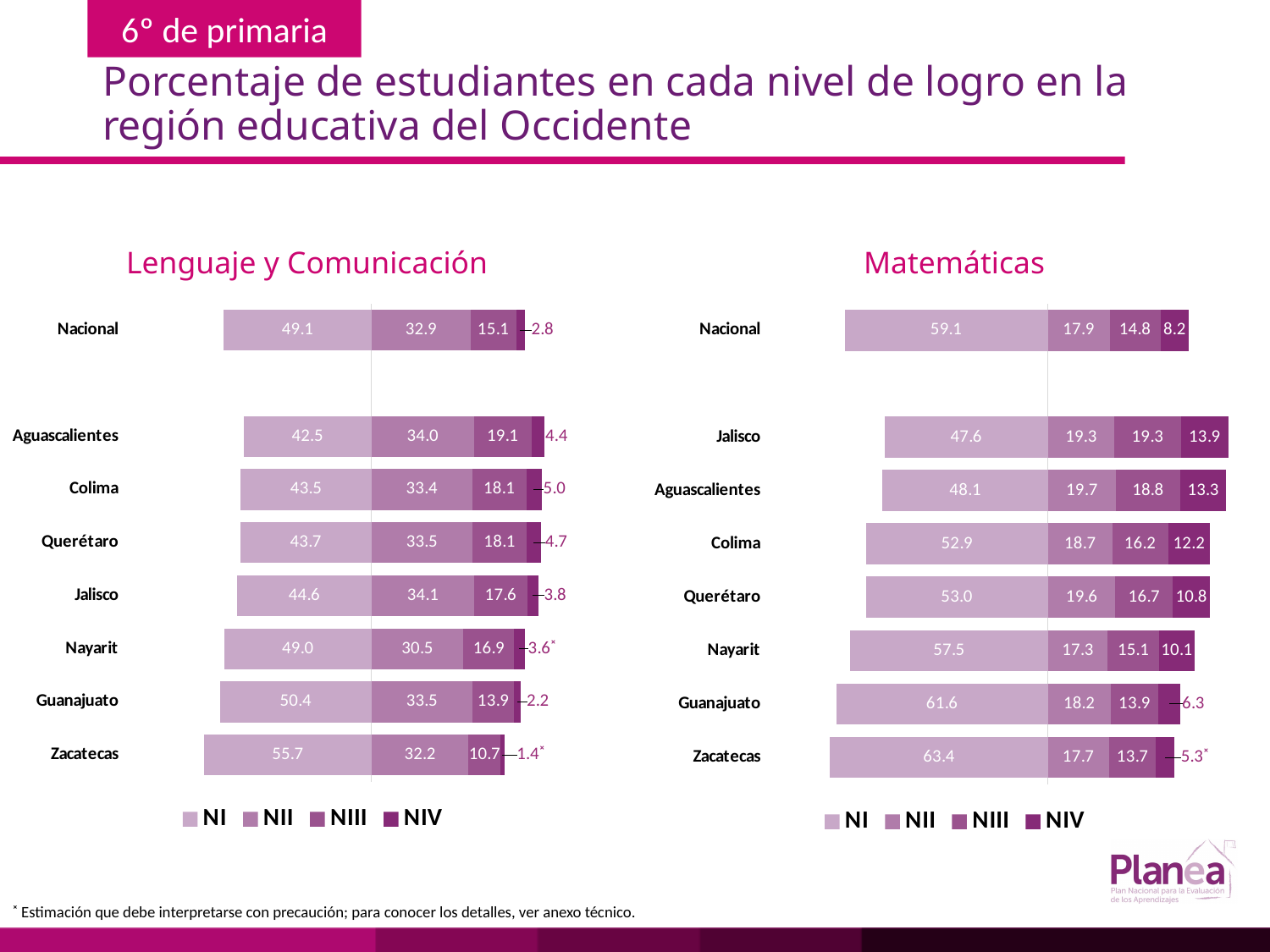
How many series does the legend of the Lenguaje y Comunicación chart list? 4 In the Matemáticas chart, what is the total of the stacked bar for Nacional? 100.0 How many categories are shown in the Matemáticas chart? 8 In the Matemáticas chart, what is the difference between the NI value for Zacatecas and the NI value for Jalisco? 15.8 In the Lenguaje y Comunicación chart, which category has the highest NI value? Zacatecas What are the legend entries of the Lenguaje y Comunicación chart? NI, NII, NIII, NIV In the Matemáticas chart, which category has the lowest NIV value? Zacatecas In the Lenguaje y Comunicación chart, which has the larger NIII value, Aguascalientes or Guanajuato? Aguascalientes In the Matemáticas chart, what is the NIV value for Jalisco? 13.9 In the Lenguaje y Comunicación chart, what is the NI value for Zacatecas? 55.7 What kind of chart is the Matemáticas chart? Stacked bar chart In the Lenguaje y Comunicación chart, what is the NIV value for Colima? 5.0